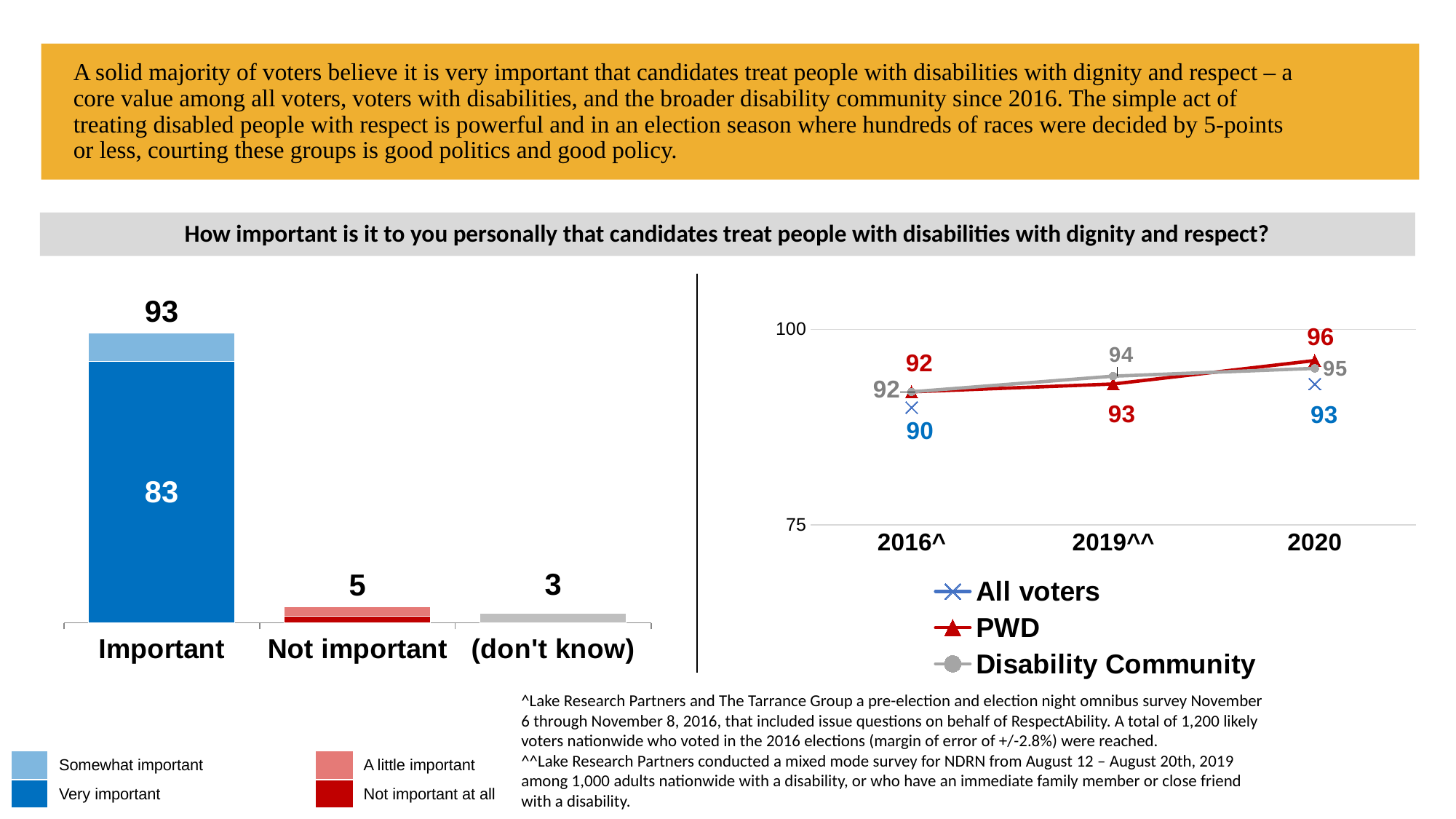
In the line chart on the right, does the PWD series rise or fall from 2016^ to 2020? rise In the line chart on the right, what is the value for Disability Community in 2019^^? 94 What kind of chart is shown on the left side of the slide? bar chart In the bar chart on the left, what is the value for (don't know)? 3 In the line chart on the right, what is the value for PWD in 2020? 96 In the bar chart on the left, what is the total value shown for the Important bar? 93 In the bar chart on the left, which category has the lowest value? (don't know) In the bar chart on the left, what is the value for Not important? 5 In the line chart on the right, how many series does the legend list? 3 In the bar chart on the left, what is the difference between the Important total (93) and the Very important portion (83)? 10 In the line chart on the right, what is the value for All voters in 2016^? 90 In the bar chart on the left, what is the value labelled for Very important within the Important bar? 83